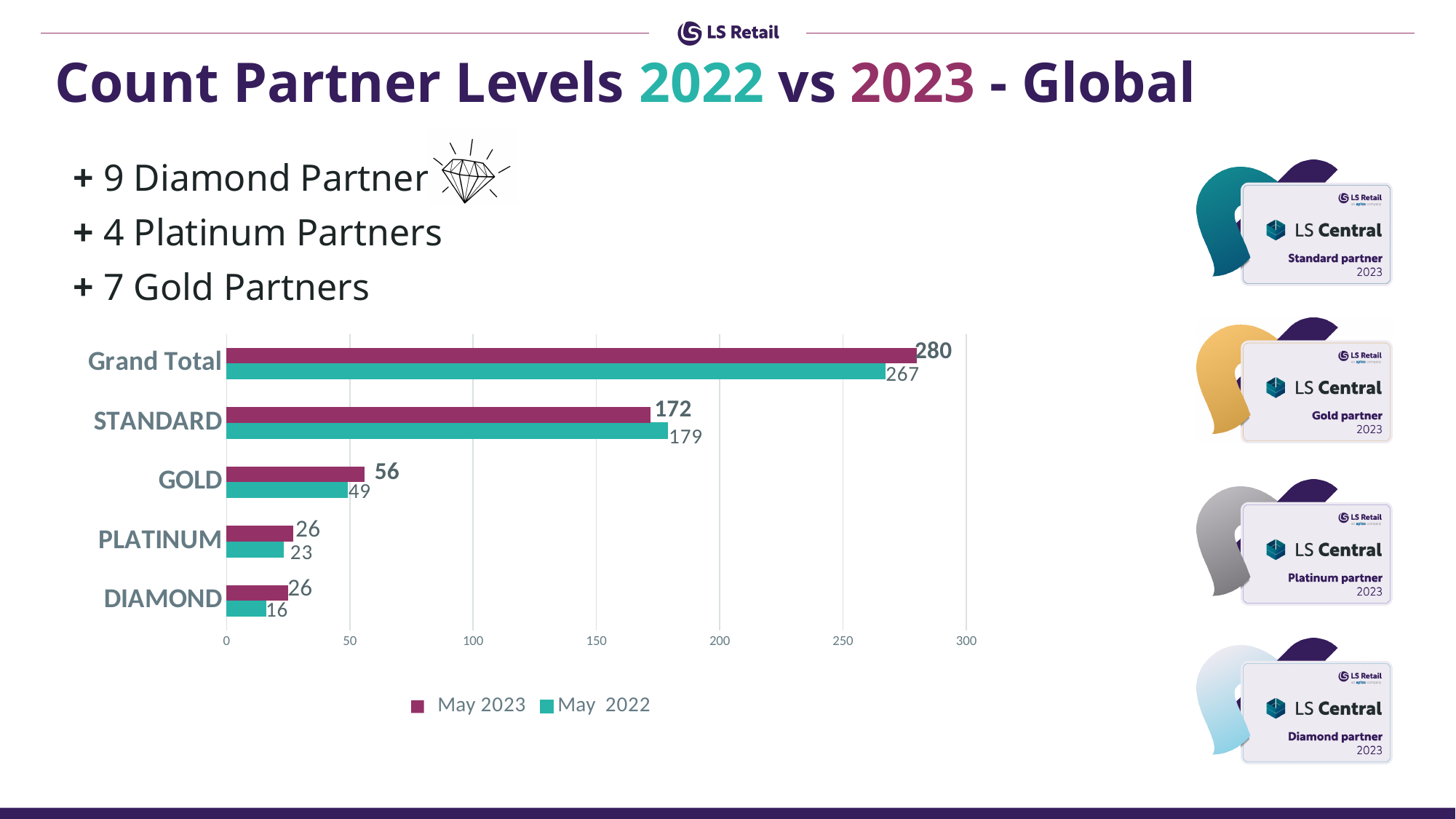
Which category has the lowest May 2022 value? DIAMOND What is the STANDARD value for May 2022? 179 What is the Grand Total value for May 2023? 280 What kind of chart is shown on the slide? Bar chart How many series does the legend list? 2 What is the DIAMOND value for May 2022? 16 What is the difference between the May 2023 and May 2022 Grand Total values? 13 What is the difference between the May 2023 and May 2022 values for DIAMOND? 10 How many categories are shown on the chart? 5 What is the GOLD value for May 2023? 56 Which is larger for STANDARD: the May 2023 value or the May 2022 value? May 2022 Excluding Grand Total, which category has the highest May 2023 value? STANDARD